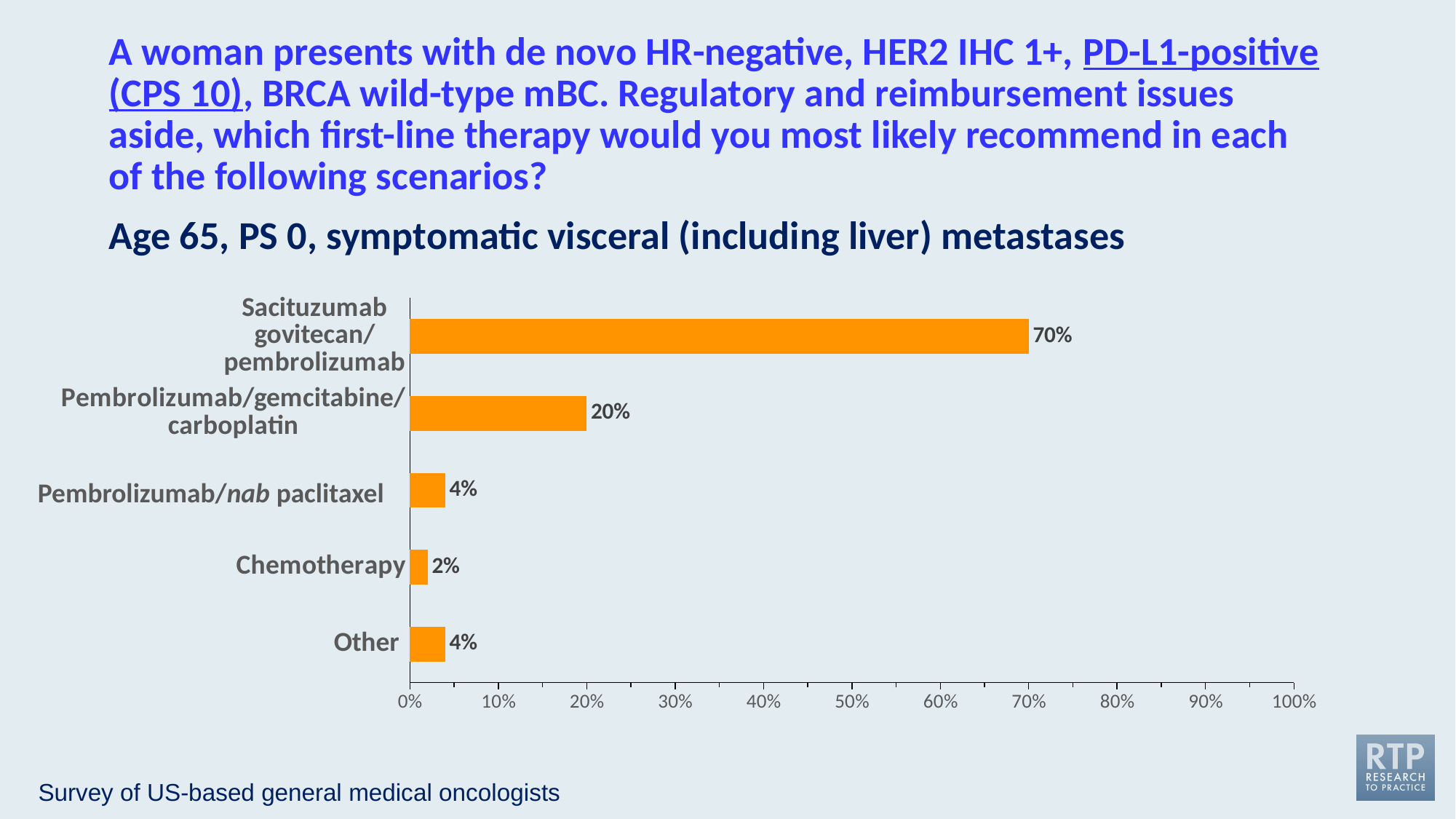
What percentage of respondents chose Sacituzumab govitecan/pembrolizumab? 70% How many therapy options are shown in the chart? 5 What percentage of respondents chose Pembrolizumab/nab paclitaxel? 4% Which therapy option received the highest percentage? Sacituzumab govitecan/pembrolizumab What percentage of respondents chose Chemotherapy? 2% What kind of chart is shown on the slide? Bar chart Which received a larger share: Pembrolizumab/nab paclitaxel or Chemotherapy? Pembrolizumab/nab paclitaxel Which therapy option received the lowest percentage? Chemotherapy What percentage of respondents chose Pembrolizumab/gemcitabine/carboplatin? 20% Is the value for Pembrolizumab/gemcitabine/carboplatin greater or less than 30%? less What is the maximum value shown on the horizontal axis? 100% What is the difference in percentage points between Sacituzumab govitecan/pembrolizumab and Pembrolizumab/gemcitabine/carboplatin? 50 percentage points